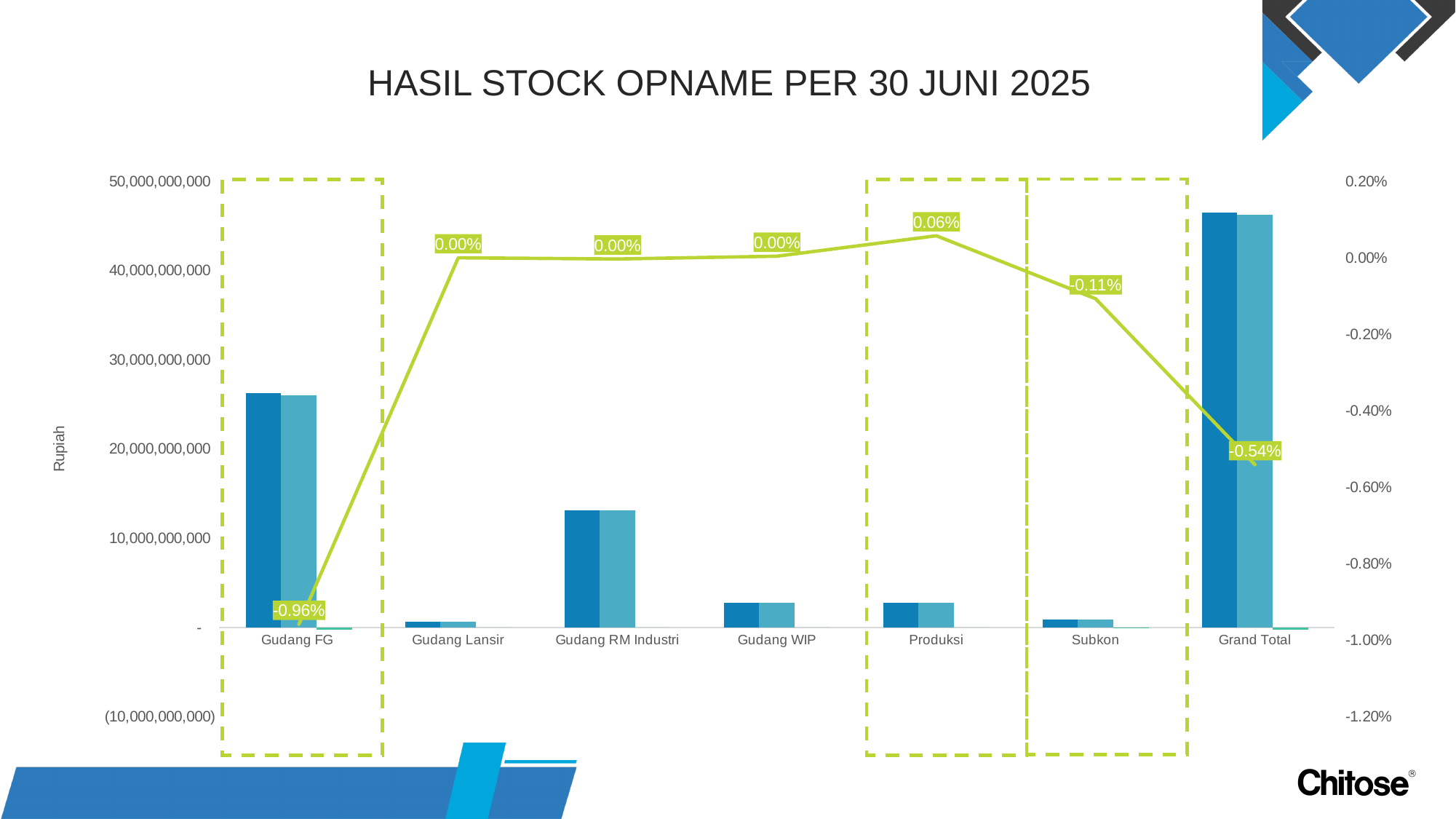
Is the dark blue bar for Gudang FG greater or less than 20,000,000,000? greater What percentage is labelled on the line for Grand Total? -0.54% What is the difference between the line percentages for Produksi and Subkon? 0.17% Is the dark blue bar for Grand Total greater or less than 40,000,000,000? greater Which has the larger line percentage, Subkon or Grand Total? Subkon Which category has the lowest percentage value on the line? Gudang FG Which category has the highest percentage value on the line? Produksi What percentage is labelled on the line for Subkon? -0.11% What percentage is labelled on the line for Produksi? 0.06% What is the title of the chart? HASIL STOCK OPNAME PER 30 JUNI 2025 How many categories are shown on the x axis? 7 What percentage is labelled on the line for Gudang FG? -0.96%